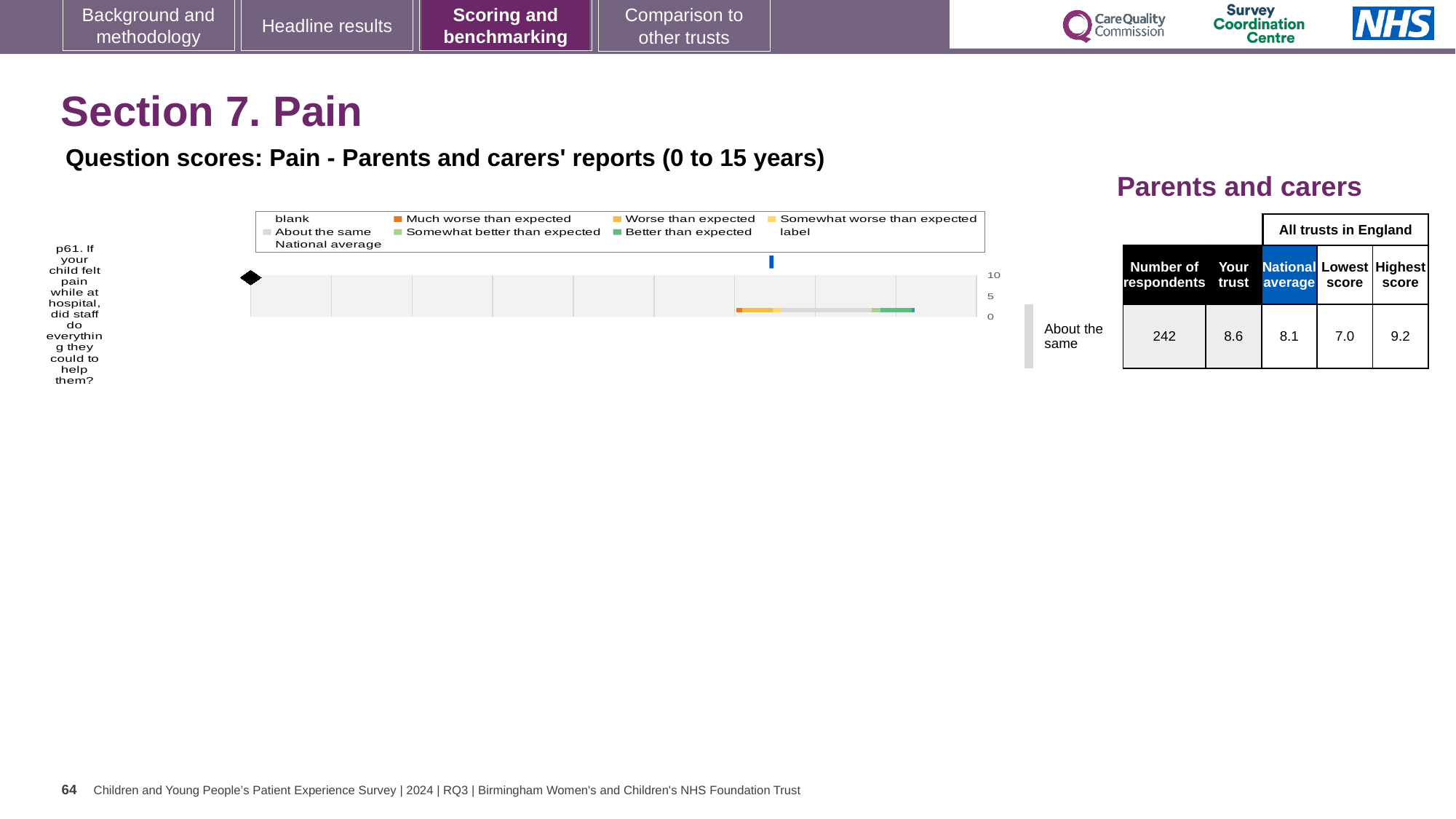
What is the lowest score across all trusts in England for question p61? 7.0 How many survey questions are plotted in the chart? 1 What is the 'Your trust' score for question p61? 8.6 Which legend entry is shown in orange in the chart? Much worse than expected What benchmark category is question p61 placed in? About the same What kind of chart is used to show the p61 question score? bar chart What is the national average score for question p61? 8.1 What is the highest score across all trusts in England for question p61? 9.2 What is the difference between the highest score and the lowest score for question p61? 2.2 How many respondents answered question p61? 242 Which is larger for question p61, the 'Your trust' score or the national average? Your trust Which legend entry is shown in dark green in the chart? Better than expected